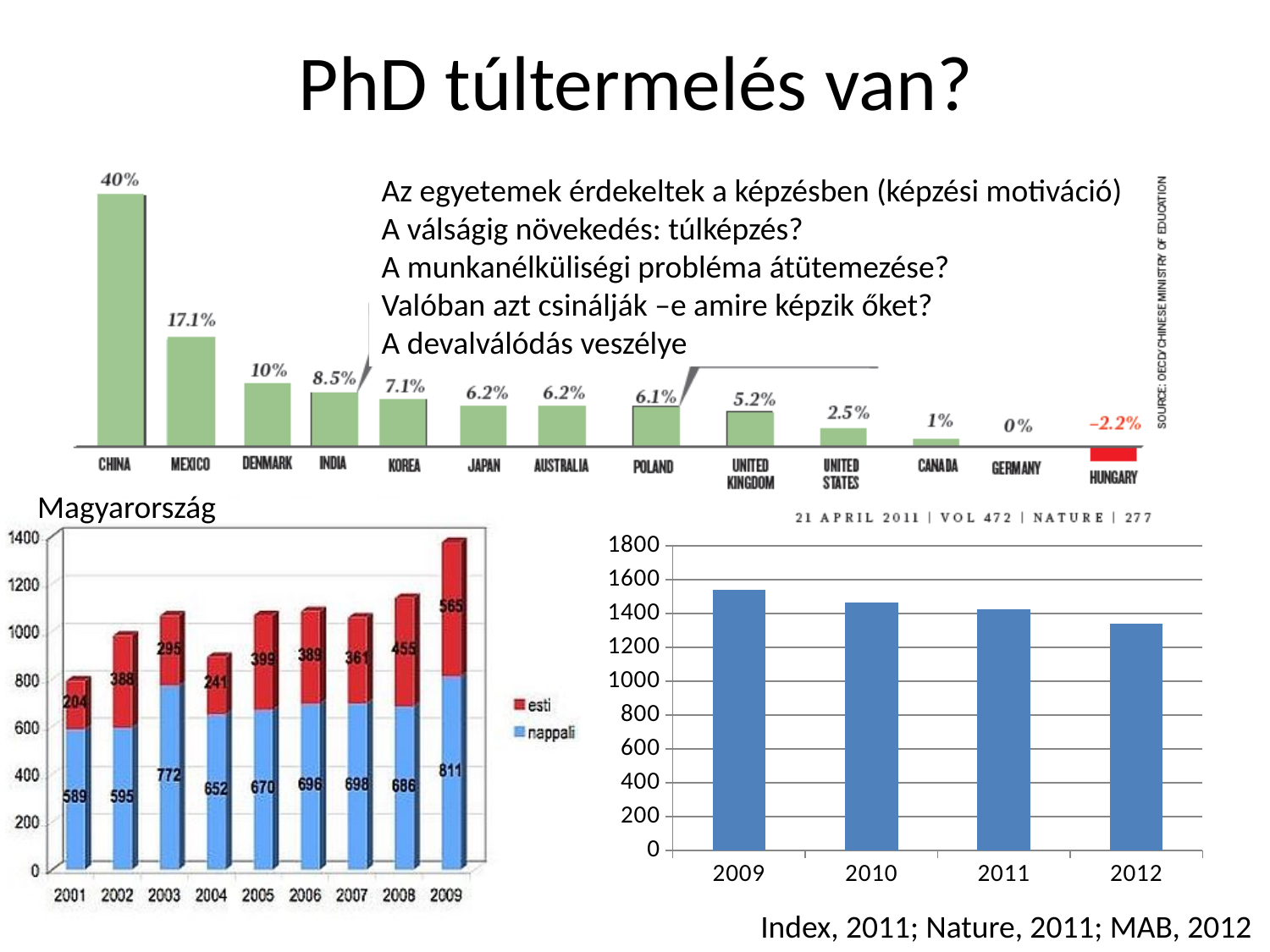
In the top chart of PhD growth by country, what is the value for China? 40% In the bottom-left Magyarország chart, which is larger in 2002, esti or nappali? nappali In the bottom-left Magyarország chart, what is the nappali value for 2003? 772 In the top chart of PhD growth by country, what is the difference between Mexico and Denmark? 7.1% In the bottom-right chart with years 2009 to 2012, do the values rise or fall from 2009 to 2012? fall In the top chart of PhD growth by country, how many countries are shown? 13 In the bottom-left Magyarország chart, what is the total of the stacked bar for 2009? 1376 In the top chart of PhD growth by country, which country has the lowest value? Hungary In the top chart of PhD growth by country, what is the value for Hungary? -2.2% In the bottom-left Magyarország chart, what is the esti value for 2009? 565 In the bottom-right chart with years 2009 to 2012, is the value for 2012 greater or less than 1400? less In the bottom-left Magyarország chart, how many series does the legend list? 2